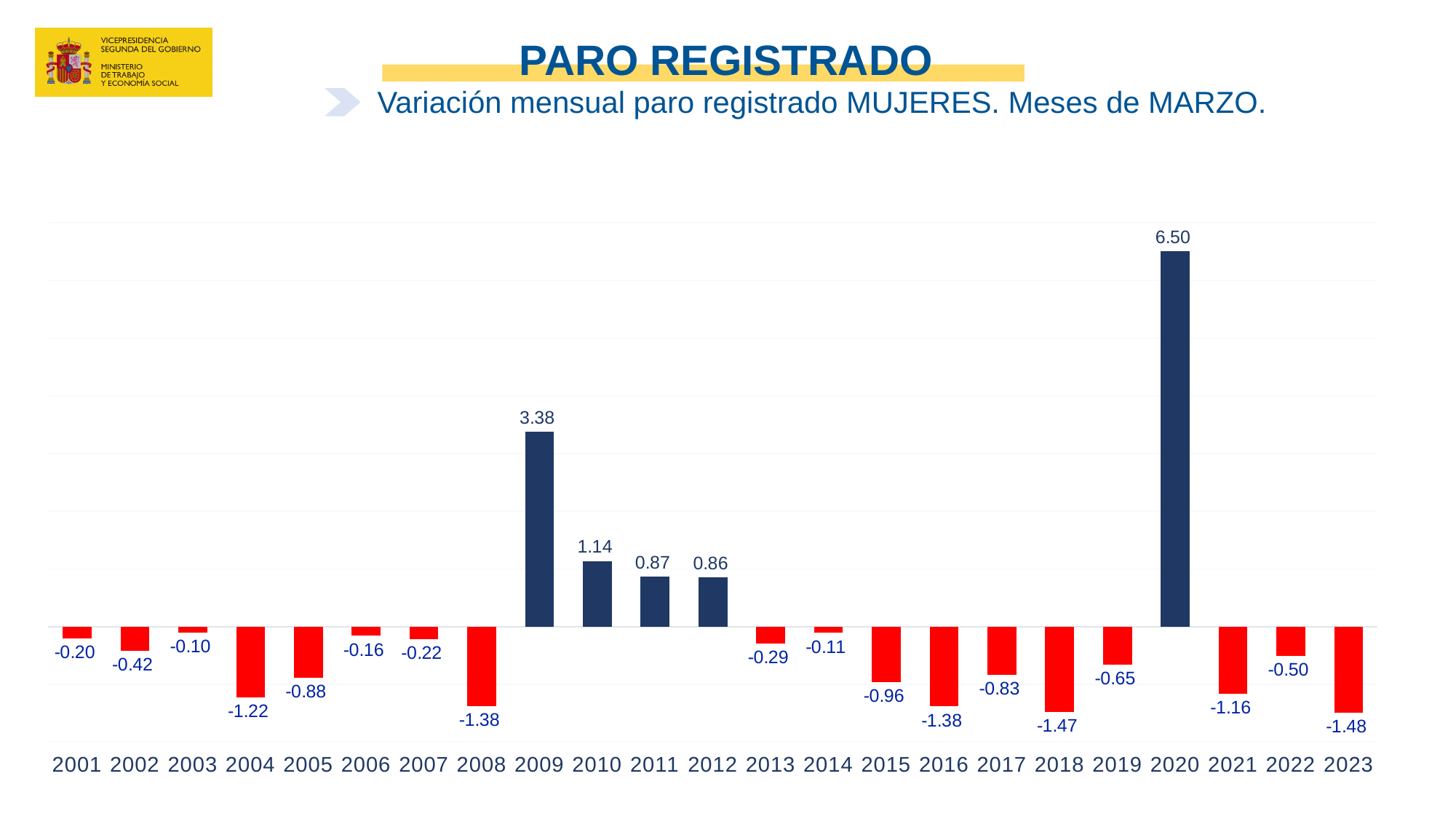
What is the value for 2014? -0.11 Which year has the lowest value? 2023 Which is larger, the value for 2010 or the value for 2011? 2010 What colour are the bars with negative values? Red What kind of chart is shown on the slide? Bar chart What is the difference between the values for 2020 and 2009? 3.12 What is the value for 2023? -1.48 How many years have a positive value? 5 What is the value for 2020? 6.50 How many years are shown on the x axis? 23 Which year has the highest value? 2020 What is the value for 2009? 3.38